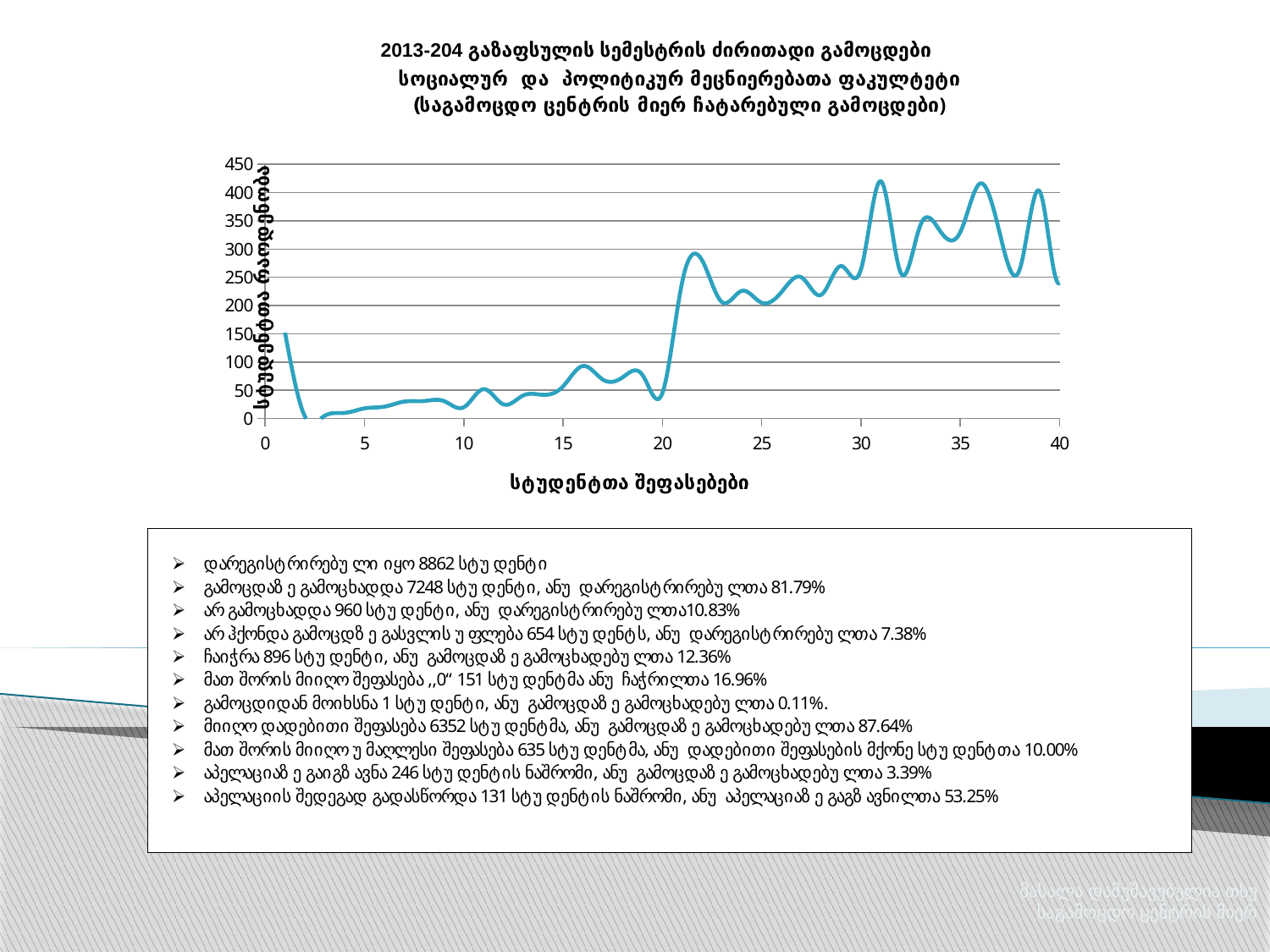
Is the value of the line at x = 20 greater or less than 100? less Is the value of the line at x = 36 greater or less than 400? greater Is the value of the line at x = 31 greater or less than 400? greater Is the lowest point of the line near the left end or the right end of the x axis? left end What is the highest value shown on the vertical axis of the chart? 450 Overall, do the values of the line rise or fall as the x axis goes from 5 to 35? rise What is the highest value shown on the horizontal axis of the chart? 40 What kind of chart is shown on the slide? line chart